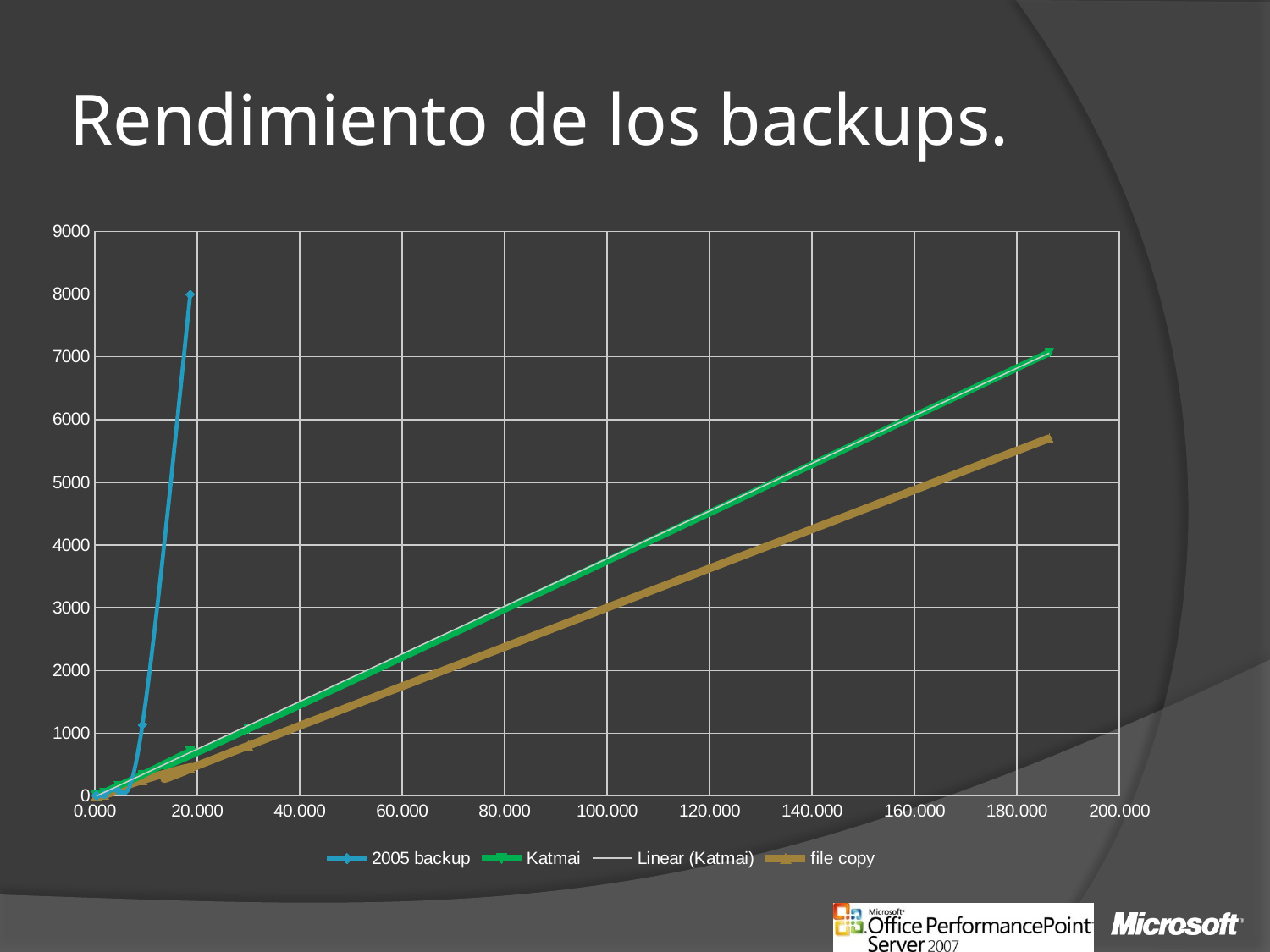
Is the highest value reached by the 2005 backup series greater or less than 7000? greater Is the highest value reached by the Katmai series greater or less than 6000? greater How many series does the chart legend list? 4 Which series has the lowest value at the right-hand end of its line, Katmai or file copy? file copy Which series reaches the highest value on the y axis? 2005 backup What kind of chart is shown on the slide? line chart Does the file copy series rise or fall along the x axis? rise Is the highest value reached by the file copy series greater or less than 6000? less Does the 2005 backup series rise or fall as the x-axis value increases? rise At an x value of 180.000, which series is higher: Katmai or file copy? Katmai Which series is drawn in green in the chart? Katmai What is the title of the slide containing the chart? Rendimiento de los backups.